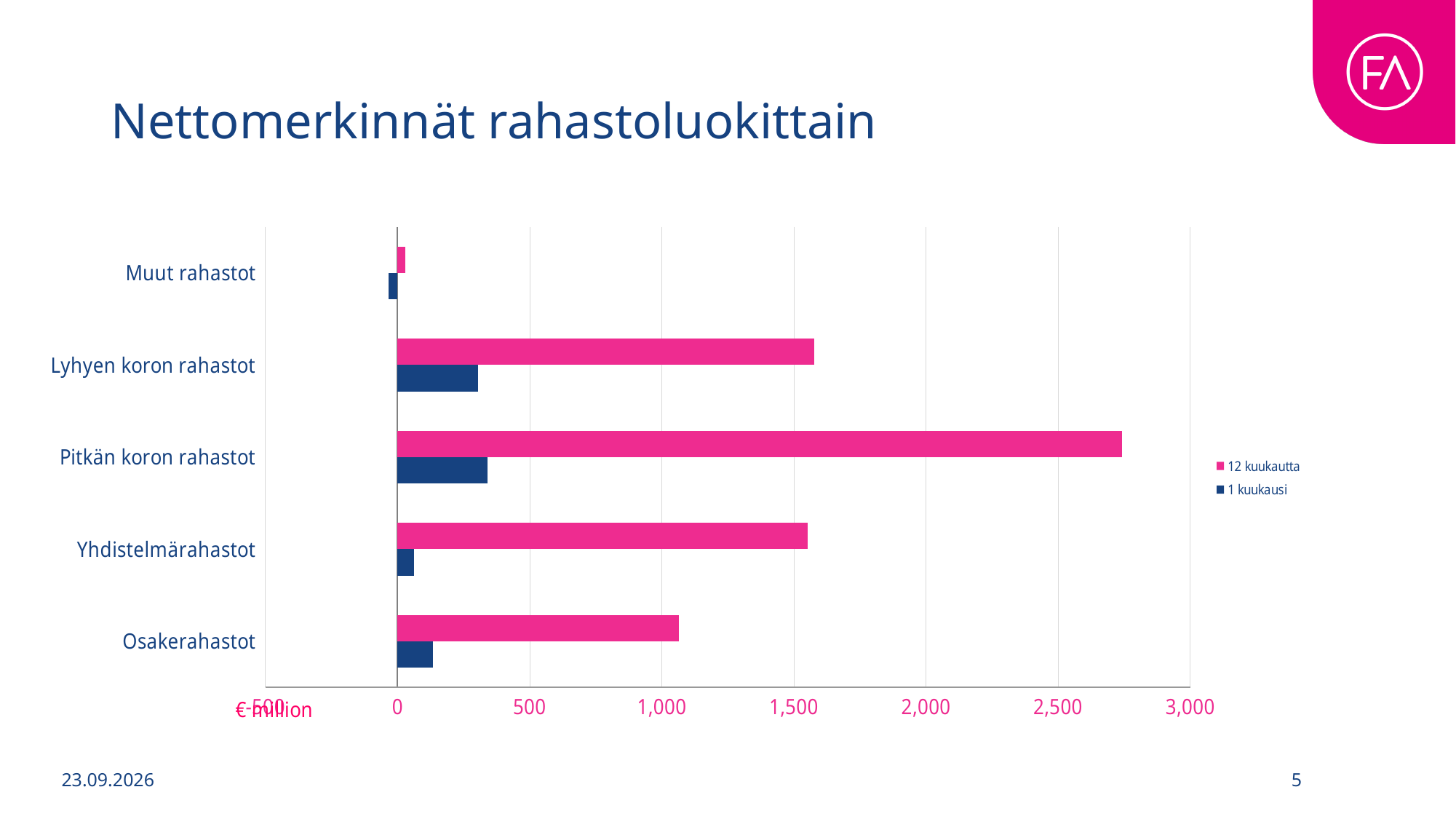
Is the 1 kuukausi value for Muut rahastot greater or less than 0? less Is the 1 kuukausi value for Yhdistelmärahastot greater or less than 500? less For the 12 kuukautta series, which is larger: Yhdistelmärahastot or Osakerahastot? Yhdistelmärahastot How many fund categories are shown on the chart? 5 Which colour represents the 1 kuukausi series in the legend? Dark blue How many series does the legend list? 2 Is the 12 kuukautta value for Osakerahastot greater or less than 1,000? greater Which category has the lowest value for the 12 kuukautta series? Muut rahastot What kind of chart is shown on the slide? Bar chart Which category has the highest value for the 12 kuukautta series? Pitkän koron rahastot Which category has the lowest value for the 1 kuukausi series? Muut rahastot